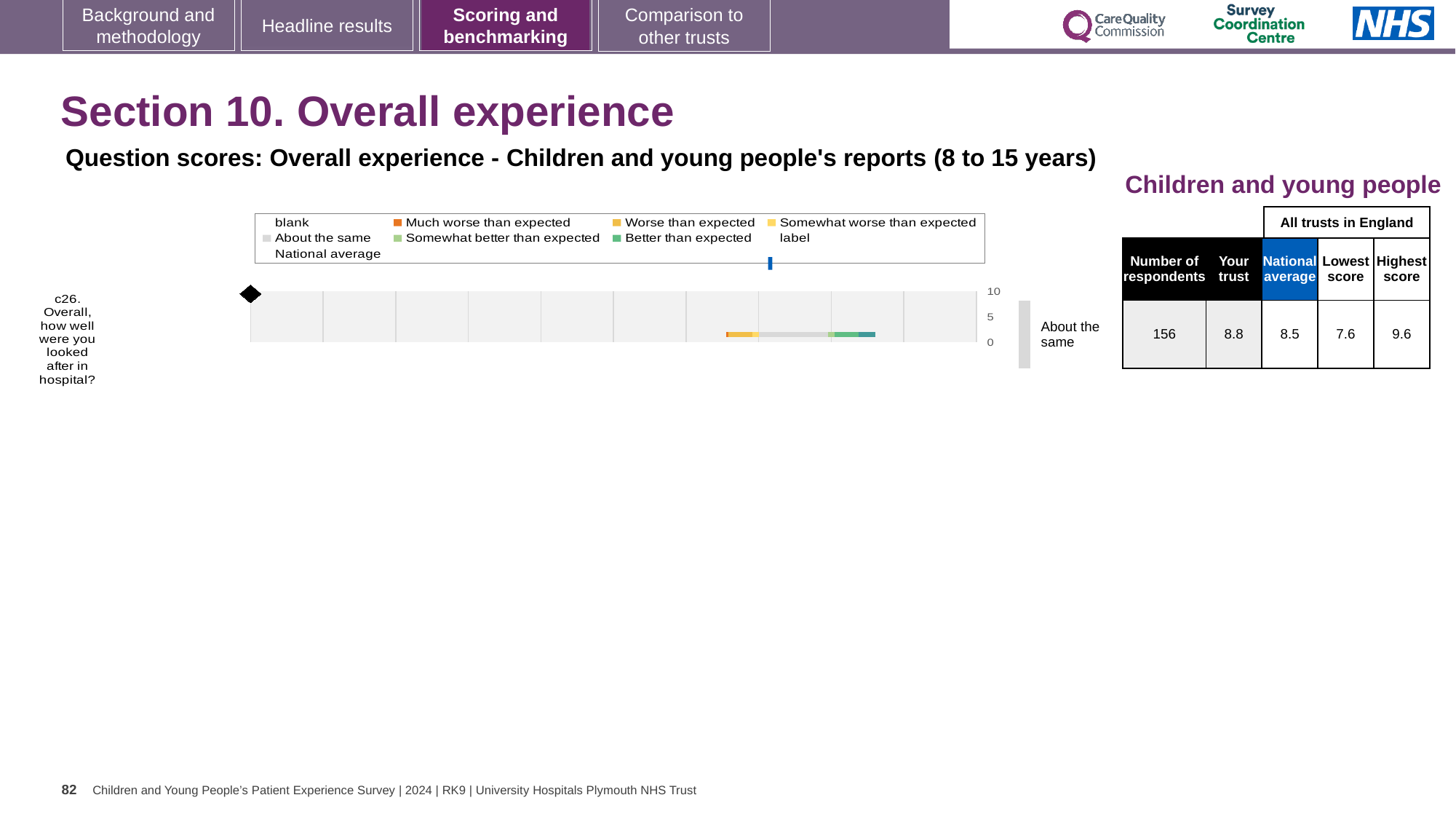
How many survey questions are plotted on the chart? 1 What is the difference between the trust's score and the national average for question c26? 0.3 Which is higher for question c26: the trust's score or the national average? Your trust Is the trust's score for question c26 greater or less than 5 on the chart's axis? greater What benchmarking category is the trust's result for question c26 placed in? About the same How many respondents answered question c26? 156 What is the lowest score among all trusts in England for question c26? 7.6 What is the highest score among all trusts in England for question c26? 9.6 What is the score for 'Your trust' on question c26 (Overall, how well were you looked after in hospital?)? 8.8 What is the title of the chart? Question scores: Overall experience - Children and young people's reports (8 to 15 years) What is the difference between the highest and lowest trust scores in England for question c26? 2.0 What is the national average score for question c26? 8.5